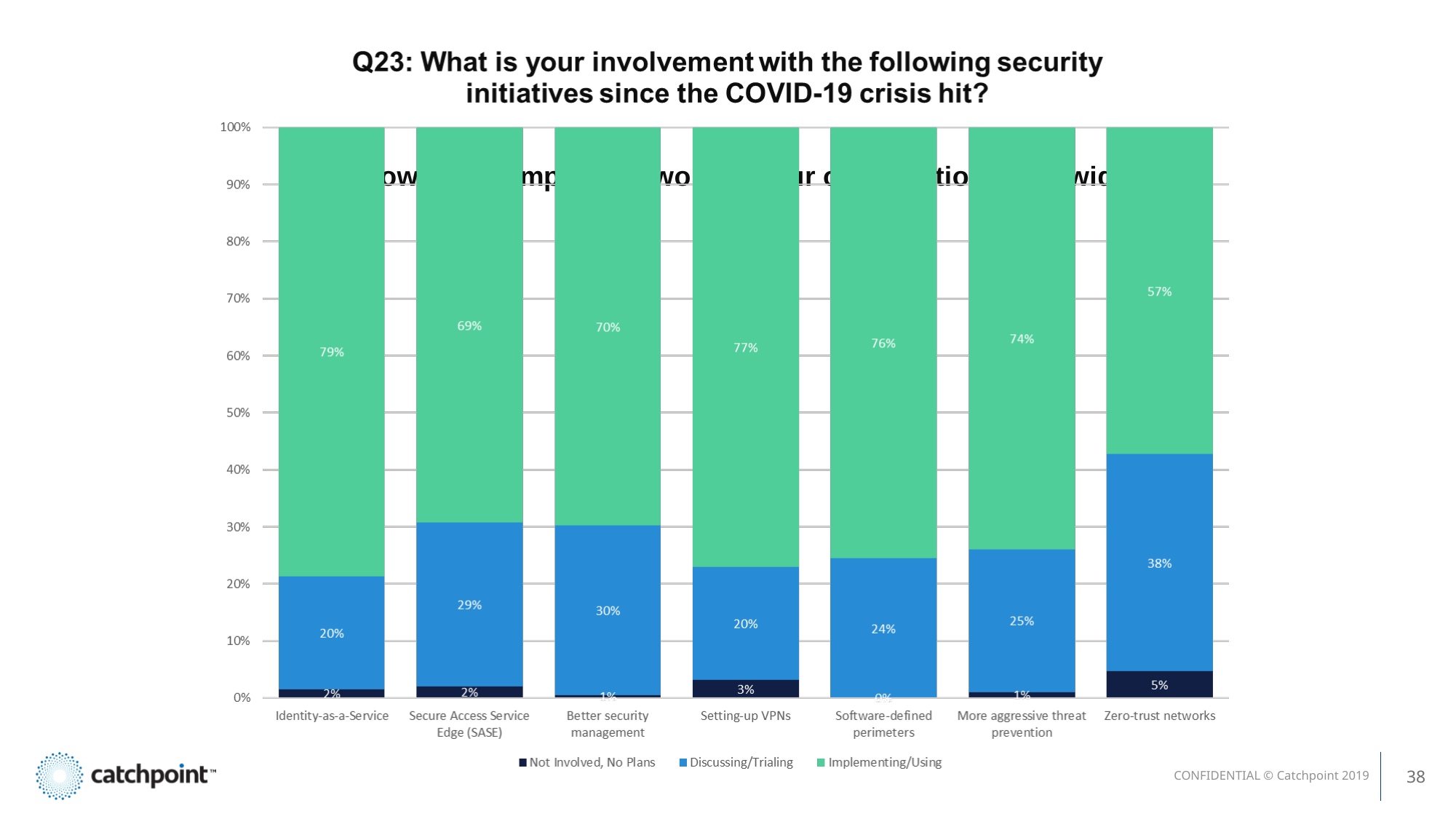
What kind of chart is shown on the slide? Stacked bar chart How many security initiatives are shown on the x axis? 7 What is the difference between the Implementing/Using values for Setting-up VPNs and Zero-trust networks? 20% Which is larger: the Discussing/Trialing value for Secure Access Service Edge (SASE) or for Software-defined perimeters? Secure Access Service Edge (SASE) What is the Not Involved, No Plans value for Setting-up VPNs? 3% Which initiative has the lowest Implementing/Using percentage? Zero-trust networks What is the Discussing/Trialing value for Zero-trust networks? 38% How many series does the legend list? 3 Which initiative has the highest Implementing/Using percentage? Identity-as-a-Service What percentage of respondents are Implementing/Using Identity-as-a-Service? 79% Which series is shown in green in the legend? Implementing/Using Which initiative has the highest Not Involved, No Plans percentage? Zero-trust networks